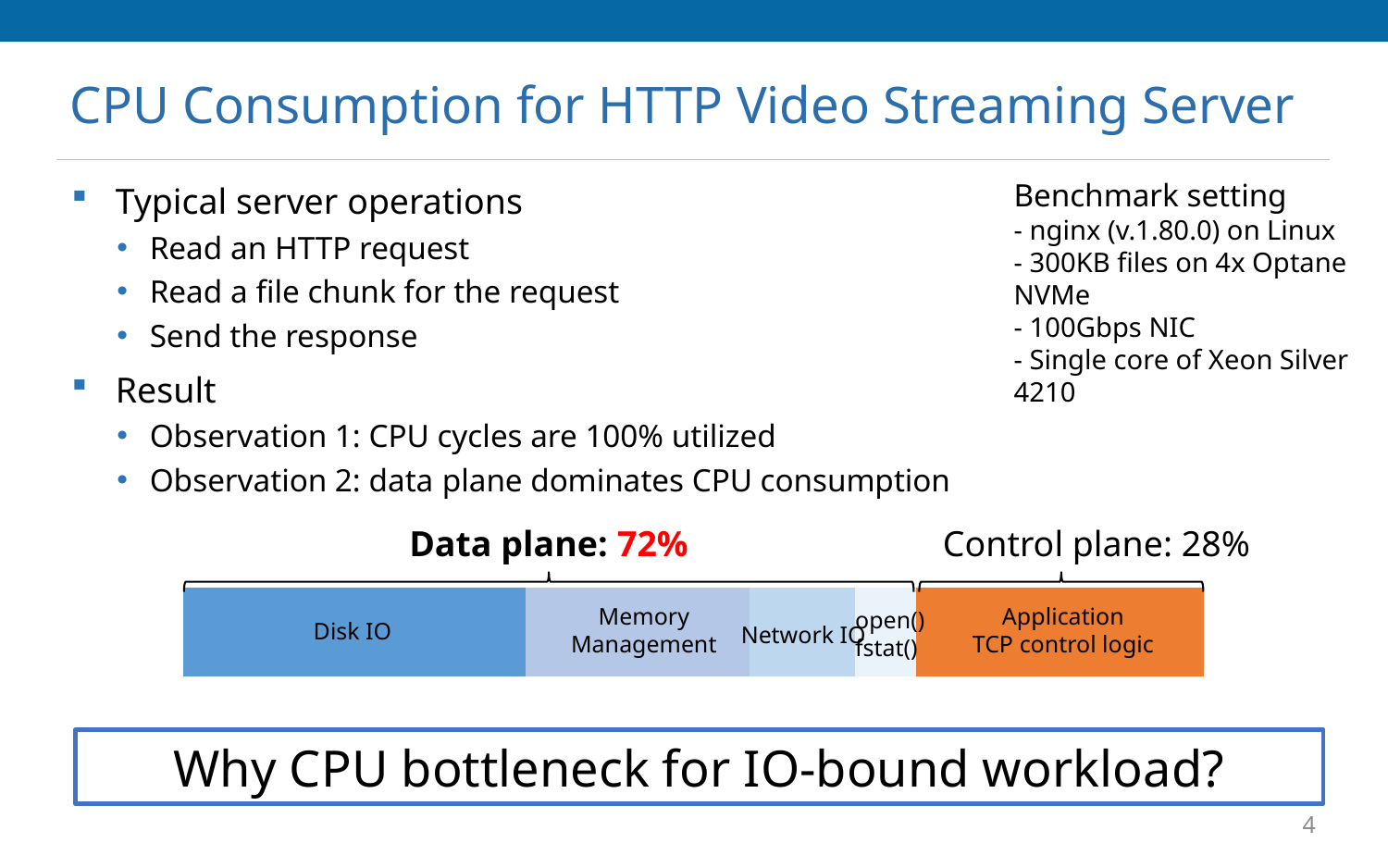
What percentage of CPU consumption is attributed to the data plane? 72% What percentage of CPU consumption is attributed to the control plane? 28% What kind of chart is shown on the slide? Stacked bar chart What colour is the control plane segment of the bar? Orange How many segments make up the CPU consumption bar? 5 By how many percentage points does the data plane's CPU share exceed the control plane's? 44 Which takes a larger share of CPU consumption, Memory Management or Network IO? Memory Management Which segment of the bar is the smallest? open() fstat() Which segment of the bar is the largest? Disk IO Which takes a larger share of CPU consumption, Disk IO or Memory Management? Disk IO What is the combined CPU share of the data plane and the control plane? 100% Which segment of the bar represents the control plane? Application TCP control logic